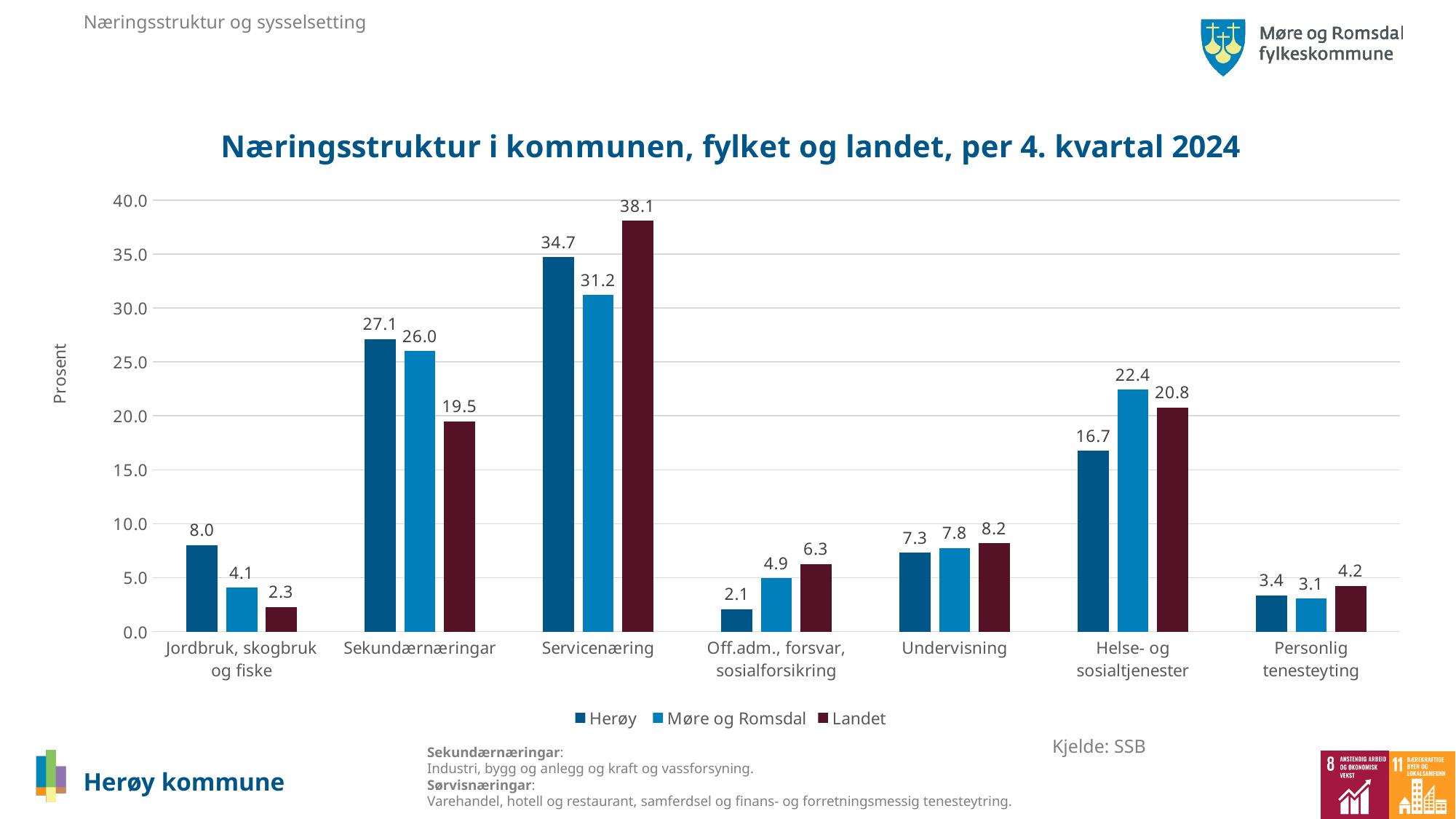
What kind of chart is shown on the slide? Bar chart Which category has the lowest value for Herøy? Off.adm., forsvar, sosialforsikring How many categories are shown on the x axis? 7 What is the value for Møre og Romsdal in the Helse- og sosialtjenester category? 22.4 Which category has the highest value for Landet? Servicenæring What is the title of the chart? Næringsstruktur i kommunen, fylket og landet, per 4. kvartal 2024 In the Sekundærnæringar category, which is larger: the value for Herøy or the value for Møre og Romsdal? Herøy What is the difference between the Herøy and Landet values in the Jordbruk, skogbruk og fiske category? 5.7 What is the value for Landet in the Sekundærnæringar category? 19.5 How many series does the legend list? 3 Is the value for Landet in the Helse- og sosialtjenester category greater or less than 20.0? greater What is the value for Herøy in the Servicenæring category? 34.7